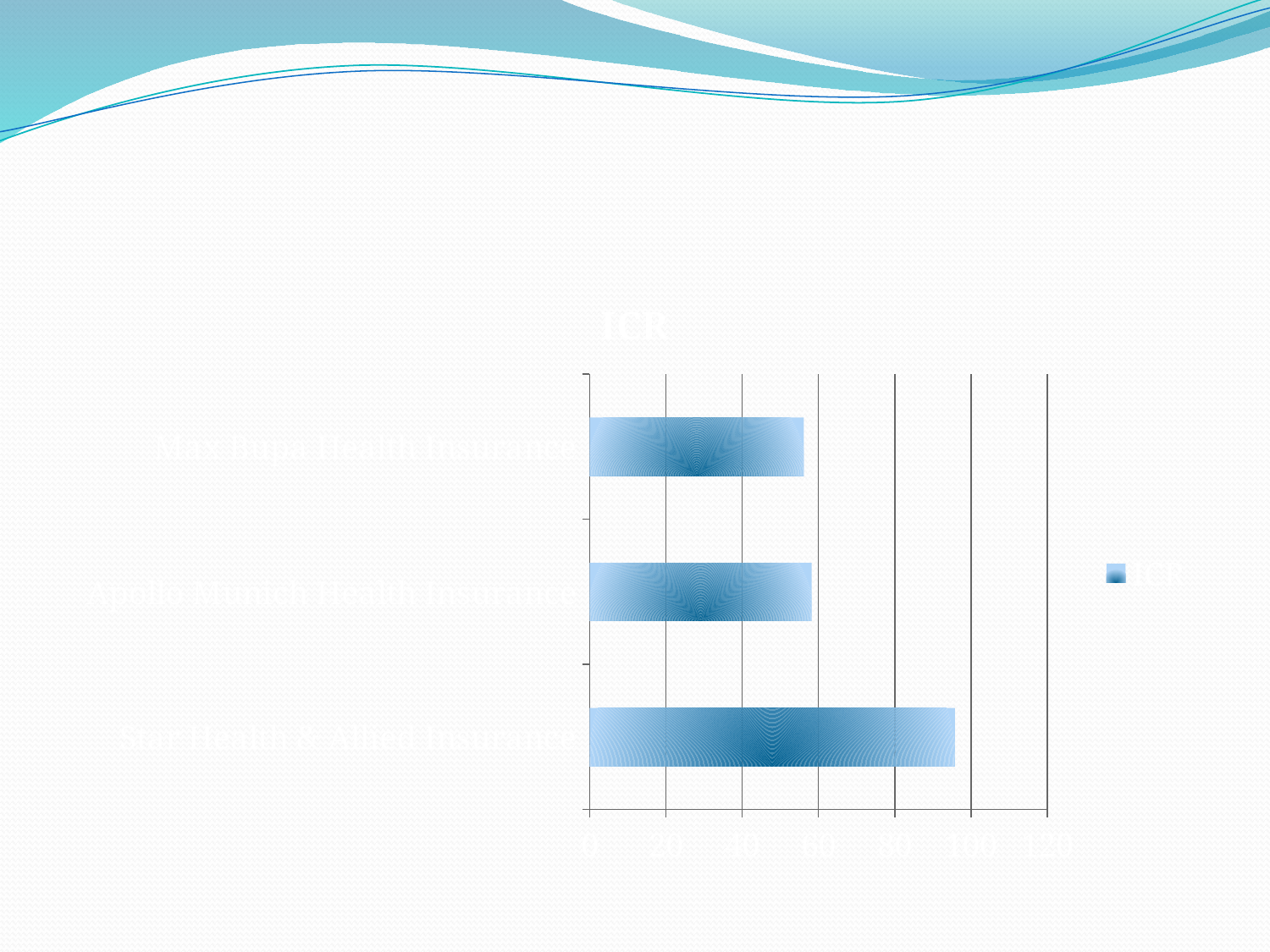
Is the value for Apollo Munich Health Insurance greater or less than 80? less Is the value for Max Bupa Health Insurance greater or less than 40? greater Which is larger, the value for Star Health & Allied Insurance or the value for Max Bupa Health Insurance? Star Health & Allied Insurance What is the title of the chart? ICR How many categories are plotted in the chart? 3 What is the name of the series shown in the legend? ICR Which category has the highest ICR value? Star Health & Allied Insurance Is the value for Apollo Munich Health Insurance greater or less than 40? greater What kind of chart is shown on the slide? bar chart How many series does the legend list? 1